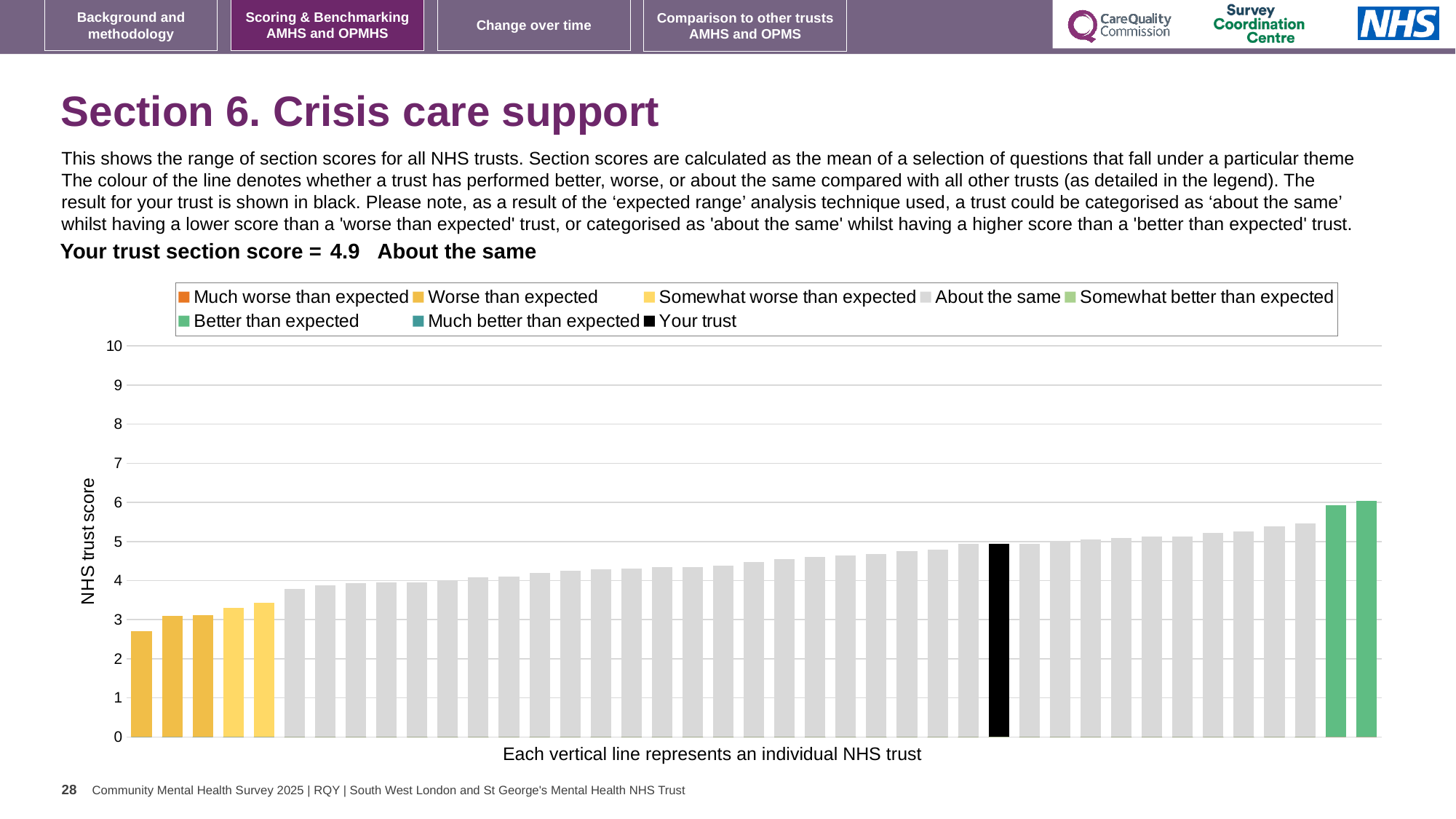
What is the title of the vertical axis? NHS trust score What is the section score for your trust shown on the slide? 4.9 Is the value of the leftmost (lowest) bar greater or less than 3? less Is the leftmost bar higher or lower than the rightmost bar? lower What kind of chart is shown on the slide? bar chart Is the value of the rightmost (highest) bar greater or less than 5? greater Do the bar values rise or fall from left to right along the x axis? rise Is the value for the black 'Your trust' bar greater or less than 4? greater How many bars are coloured in the 'Worse than expected' colour? 3 Which category is your trust placed in according to the slide? About the same How many entries does the chart legend list? 8 How many bars are coloured green (better than expected)? 2